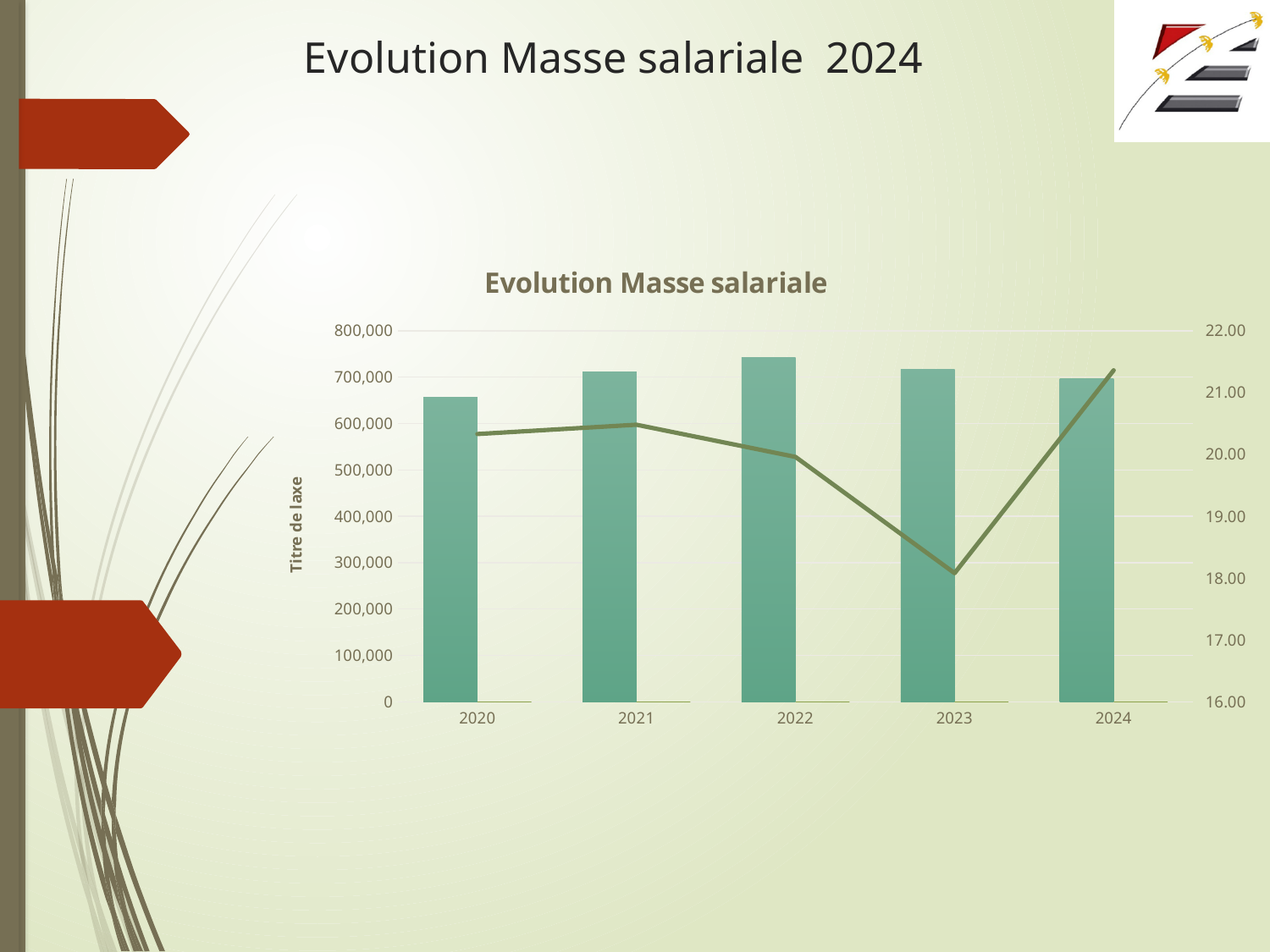
What is the title of the chart? Evolution Masse salariale On the right axis, is the line value for 2023 greater or less than 19.00? less Is the bar value for 2023 greater or less than 600,000? greater Is the bar value for 2020 greater or less than 700,000? less Does the line rise or fall between 2022 and 2023? fall In which year does the line reach its highest point? 2024 Which year has the shortest bar in the chart? 2020 In which year does the line reach its lowest point? 2023 Which year has the tallest bar in the chart? 2022 How many years are shown on the x axis of the chart? 5 What kind of chart is shown on the slide? A combined bar and line chart